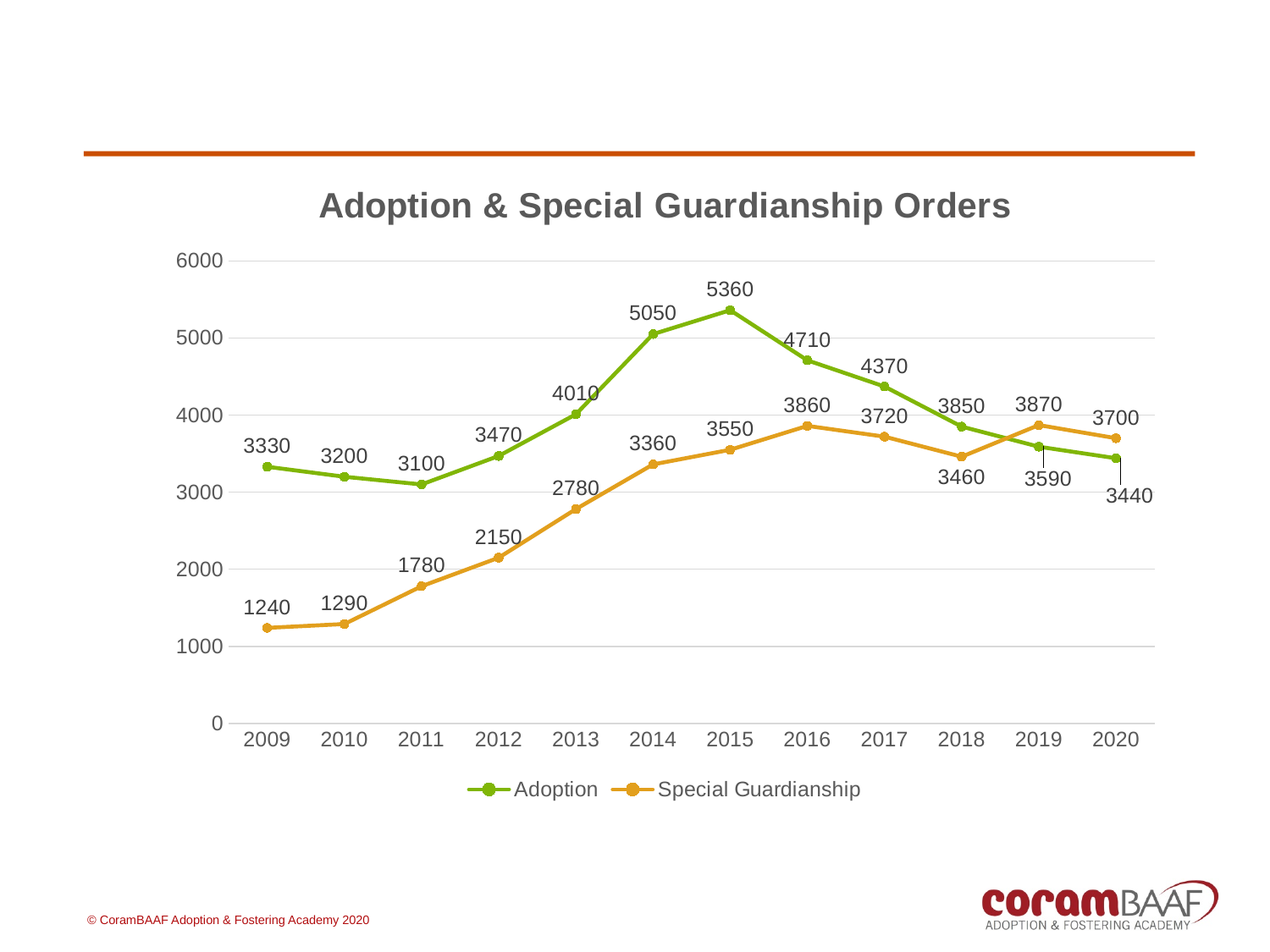
What is the title of the chart? Adoption & Special Guardianship Orders How many years are shown on the x axis? 12 In which year is the Special Guardianship series at its lowest? 2009 What is the difference between the Adoption and Special Guardianship values in 2014? 1690 What type of chart is shown on the slide? Line chart Which colour is used for the Adoption line? Green In which year is the Adoption series at its highest? 2015 What is the Special Guardianship value for 2009? 1240 Does the Special Guardianship series rise or fall from 2009 to 2016? Rise What is the Adoption value for 2015? 5360 In 2019, which series has the larger value, Adoption or Special Guardianship? Special Guardianship How many series does the legend list? 2